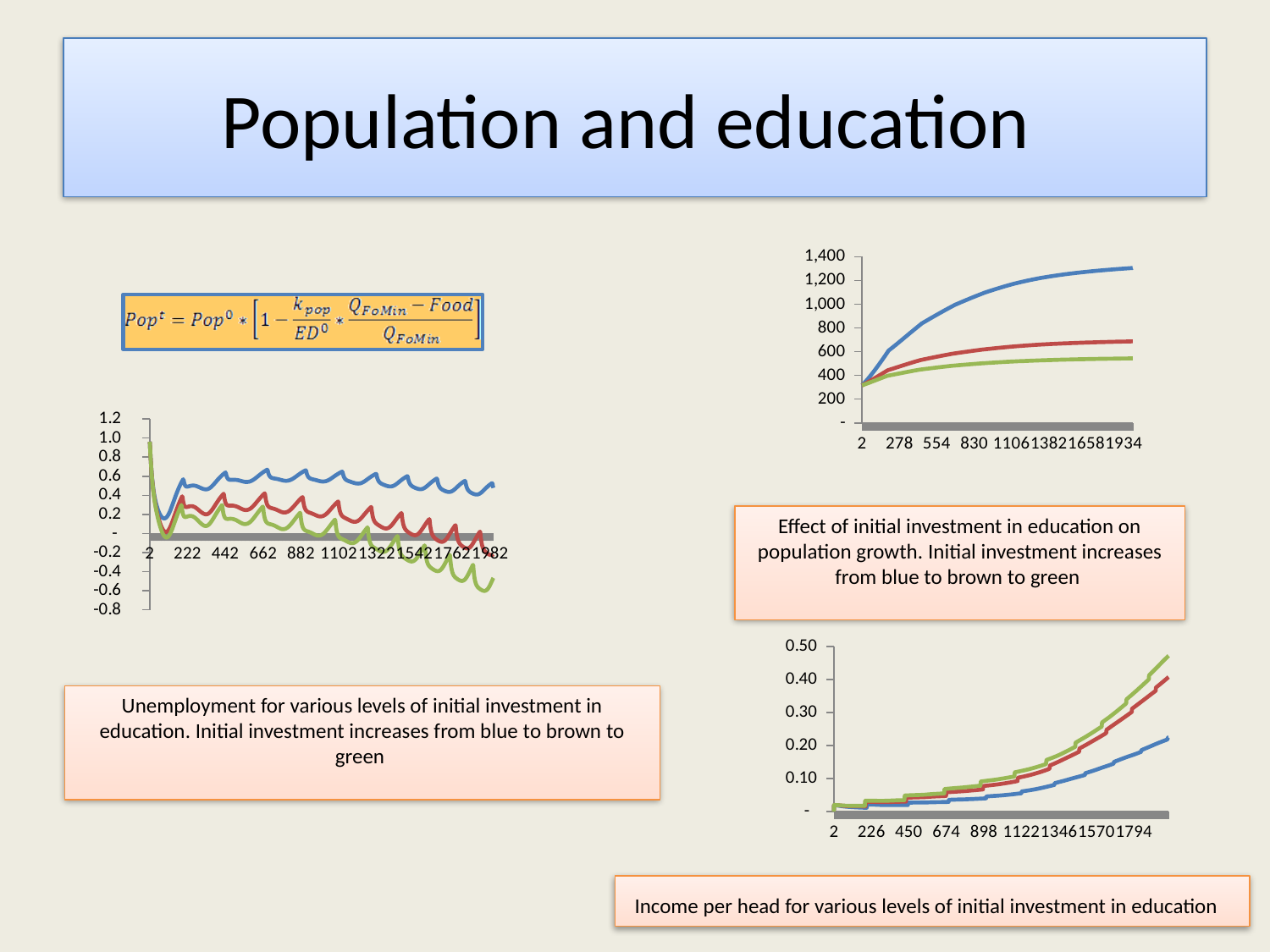
On the left unemployment chart, is the final value of the blue line greater or less than 0.2? greater On the bottom-right income per head chart, which coloured line is highest at the right end of the x axis? green On the top-right population growth chart, is the final value of the blue line greater or less than 1,000? greater What kind of chart is the top-right chart showing population growth? line chart On the top-right population growth chart, is the final value of the green line greater or less than 800? less According to the captions, which line colour represents the highest initial investment in education? green How many lines are plotted on the top-right population growth chart? 3 On the top-right population growth chart, which coloured line is highest at the right end of the x axis? blue On the top-right population growth chart, do the lines rise or fall along the x axis? rise On the left unemployment chart, which coloured line is lowest at the right end of the x axis? green